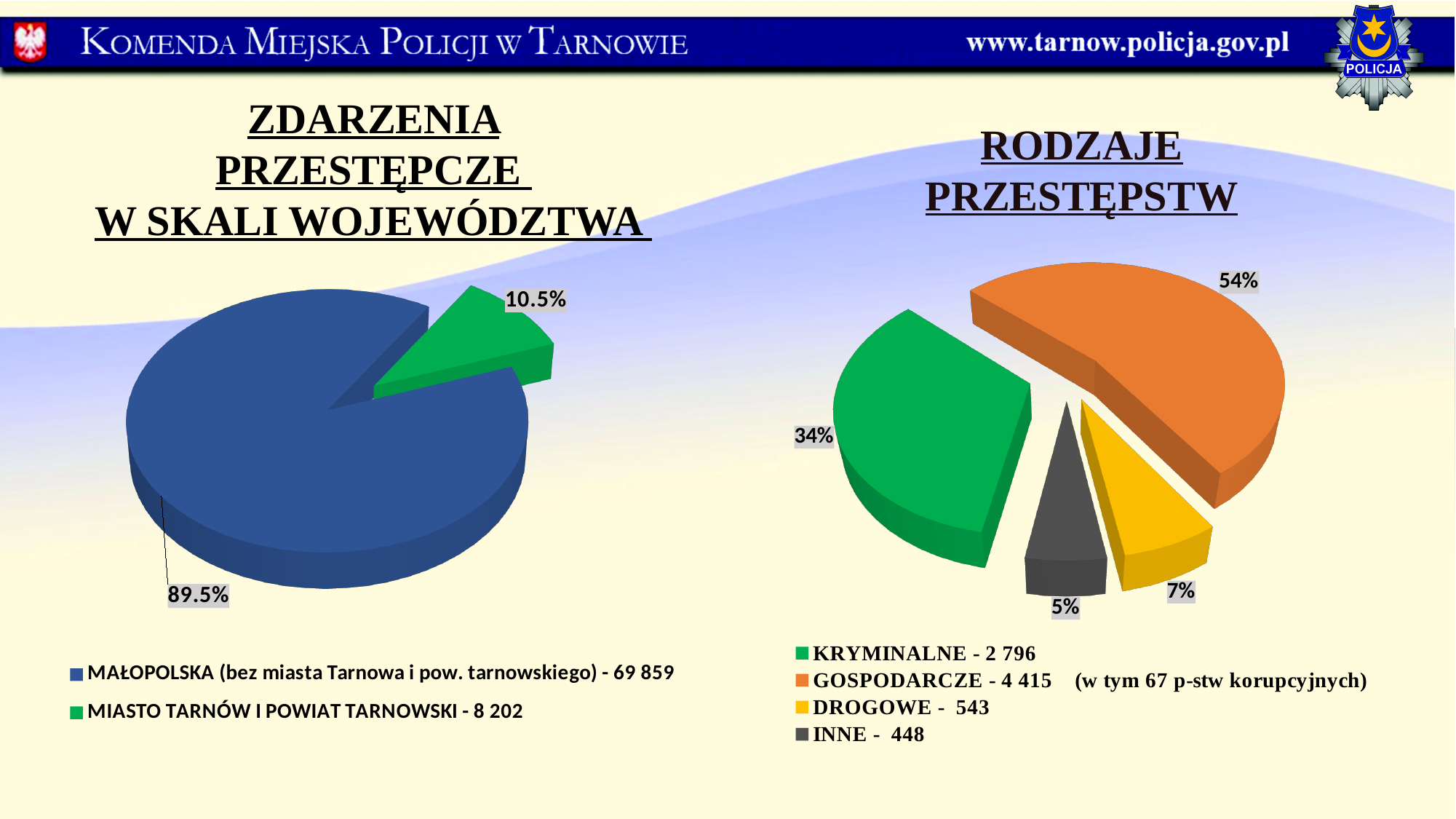
In the left chart, 'ZDARZENIA PRZESTĘPCZE W SKALI WOJEWÓDZTWA', how many slices does the pie have? 2 What kind of chart is the left chart, 'ZDARZENIA PRZESTĘPCZE W SKALI WOJEWÓDZTWA'? pie chart In the right chart, 'RODZAJE PRZESTĘPSTW', what colour is the GOSPODARCZE slice? orange In the left chart, 'ZDARZENIA PRZESTĘPCZE W SKALI WOJEWÓDZTWA', what share of the pie does MIASTO TARNÓW I POWIAT TARNOWSKI have? 10.5% In the left chart, 'ZDARZENIA PRZESTĘPCZE W SKALI WOJEWÓDZTWA', what value is given in the legend for MIASTO TARNÓW I POWIAT TARNOWSKI? 8 202 In the right chart, 'RODZAJE PRZESTĘPSTW', how many categories does the legend list? 4 In the right chart, 'RODZAJE PRZESTĘPSTW', what value is given in the legend for DROGOWE? 543 In the right chart, 'RODZAJE PRZESTĘPSTW', which category has the largest slice? GOSPODARCZE In the right chart, 'RODZAJE PRZESTĘPSTW', what share of the pie does KRYMINALNE have? 34% In the left chart, 'ZDARZENIA PRZESTĘPCZE W SKALI WOJEWÓDZTWA', what share of the pie does MAŁOPOLSKA (bez miasta Tarnowa i pow. tarnowskiego) have? 89.5% In the right chart, 'RODZAJE PRZESTĘPSTW', what is the difference in percentage points between the GOSPODARCZE and KRYMINALNE slices? 20 percentage points In the right chart, 'RODZAJE PRZESTĘPSTW', which category has the smallest slice? INNE